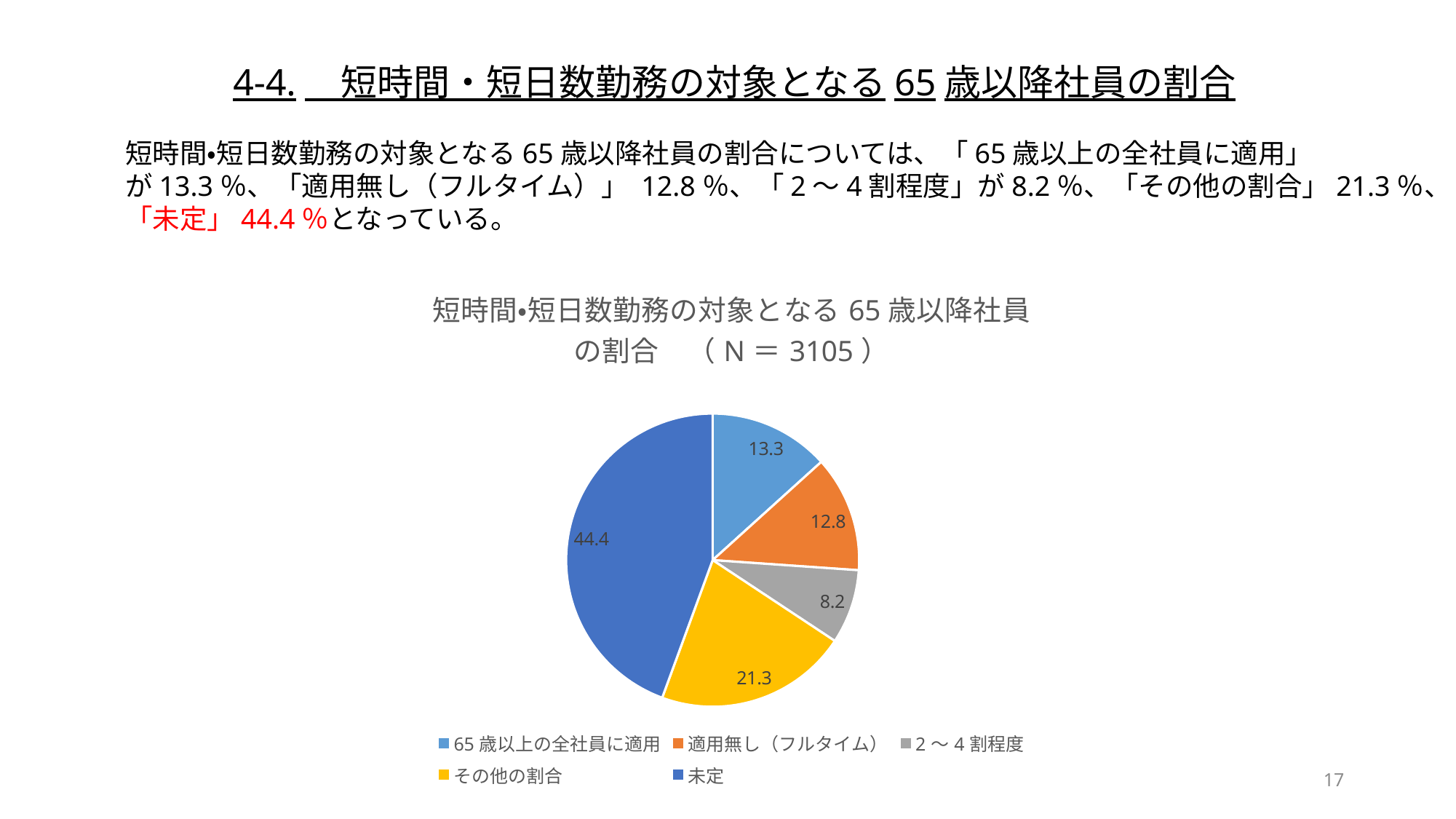
What is the value for 未定 in the pie chart? 44.4 What is the difference between the values for 未定 and その他の割合? 23.1 What is the value for 適用無し（フルタイム）? 12.8 What is the value for 65歳以上の全社員に適用? 13.3 Which category has the largest slice? 未定 What is the value for 2～4割程度? 8.2 What is the N value shown in the chart title? 3105 How many categories does the pie chart have? 5 Which category has the smallest slice? 2～4割程度 What is the value for その他の割合? 21.3 Which is larger, the value for 65歳以上の全社員に適用 or the value for 2～4割程度? 65歳以上の全社員に適用 What kind of chart is shown on the slide? pie chart